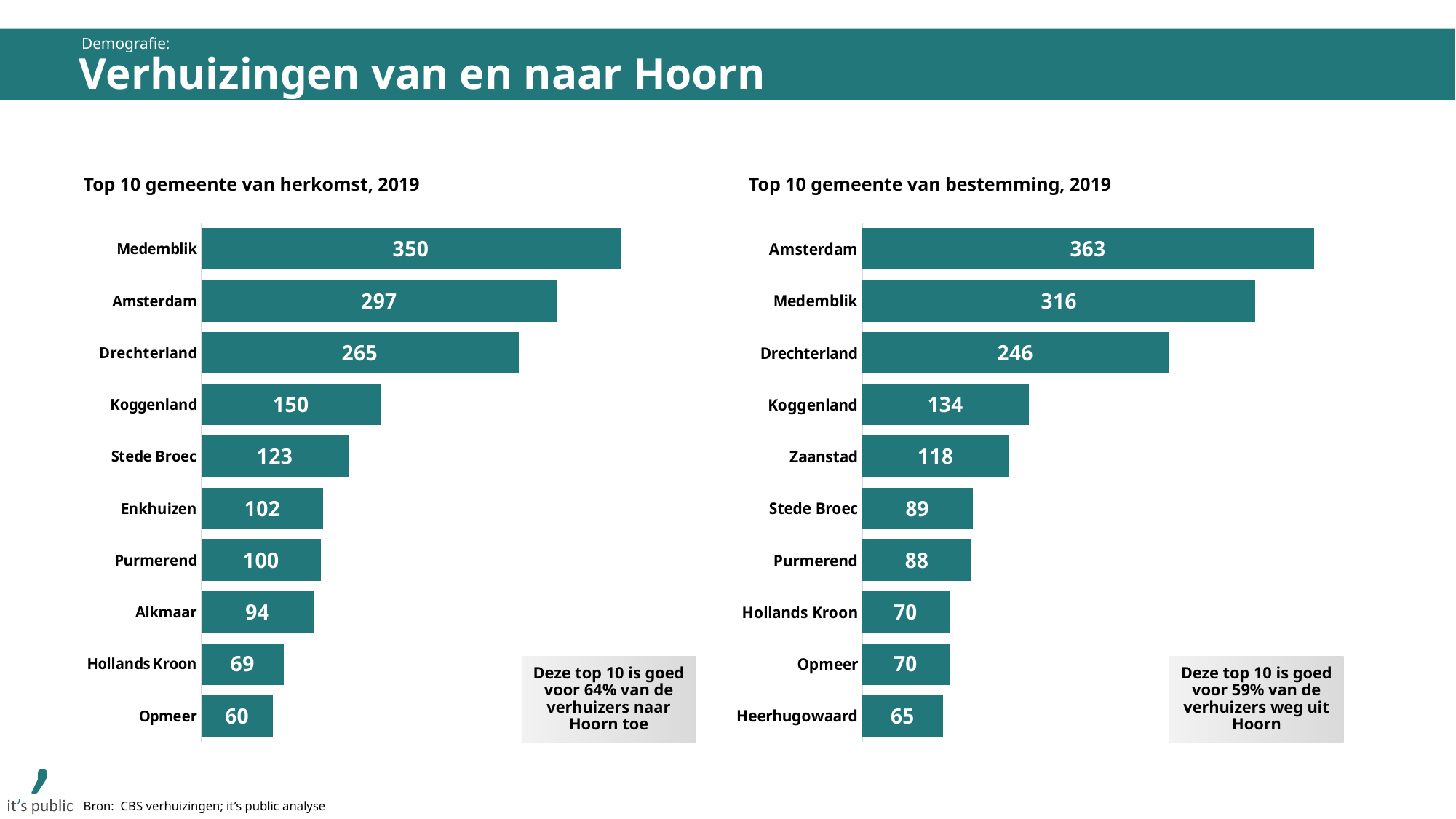
In the chart 'Top 10 gemeente van herkomst, 2019', what is the difference between the values for Medemblik and Amsterdam? 53 How many municipalities are shown in the chart 'Top 10 gemeente van bestemming, 2019'? 10 What kind of chart is 'Top 10 gemeente van herkomst, 2019'? Bar chart According to the text box next to the chart 'Top 10 gemeente van herkomst, 2019', what share of movers to Hoorn does this top 10 account for? 64% In the chart 'Top 10 gemeente van herkomst, 2019', which municipality has the highest value? Medemblik In the chart 'Top 10 gemeente van bestemming, 2019', what is the value for Zaanstad? 118 In the chart 'Top 10 gemeente van bestemming, 2019', what is the difference between the values for Amsterdam and Medemblik? 47 In the chart 'Top 10 gemeente van bestemming, 2019', what is the value for Hollands Kroon? 70 In the chart 'Top 10 gemeente van herkomst, 2019', what is the value for Opmeer? 60 In the chart 'Top 10 gemeente van herkomst, 2019', which is larger: the value for Koggenland or the value for Stede Broec? Koggenland In the chart 'Top 10 gemeente van herkomst, 2019', what is the value for Drechterland? 265 In the chart 'Top 10 gemeente van bestemming, 2019', which municipality has the lowest value? Heerhugowaard